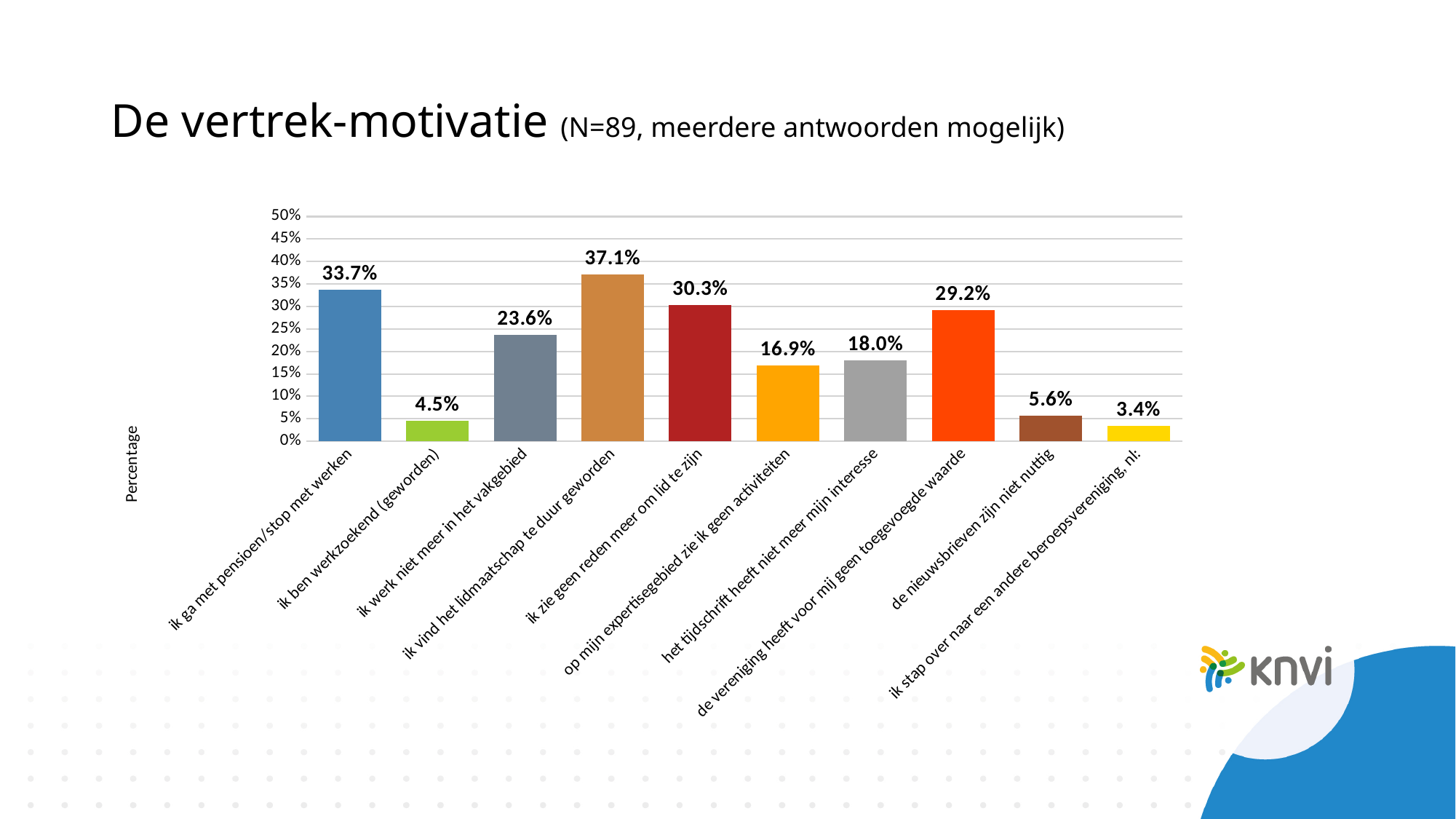
What is the value for 'de nieuwsbrieven zijn niet nuttig'? 5.6% Which category has the lowest value? ik stap over naar een andere beroepsvereniging, nl: What is the difference between 'ik zie geen reden meer om lid te zijn' and 'de vereniging heeft voor mij geen toegevoegde waarde'? 1.1% What is the value for 'ik ga met pensioen/stop met werken'? 33.7% What is the value for 'ik vind het lidmaatschap te duur geworden'? 37.1% Which is larger: 'het tijdschrift heeft niet meer mijn interesse' or 'op mijn expertisegebied zie ik geen activiteiten'? het tijdschrift heeft niet meer mijn interesse Which category has the highest value? ik vind het lidmaatschap te duur geworden What kind of chart is shown on the slide? bar chart What is the label of the vertical axis? Percentage What is the sample size (N) stated in the slide title? 89 Is the value for 'ik werk niet meer in het vakgebied' greater or less than 20%? greater How many categories are shown in the chart? 10